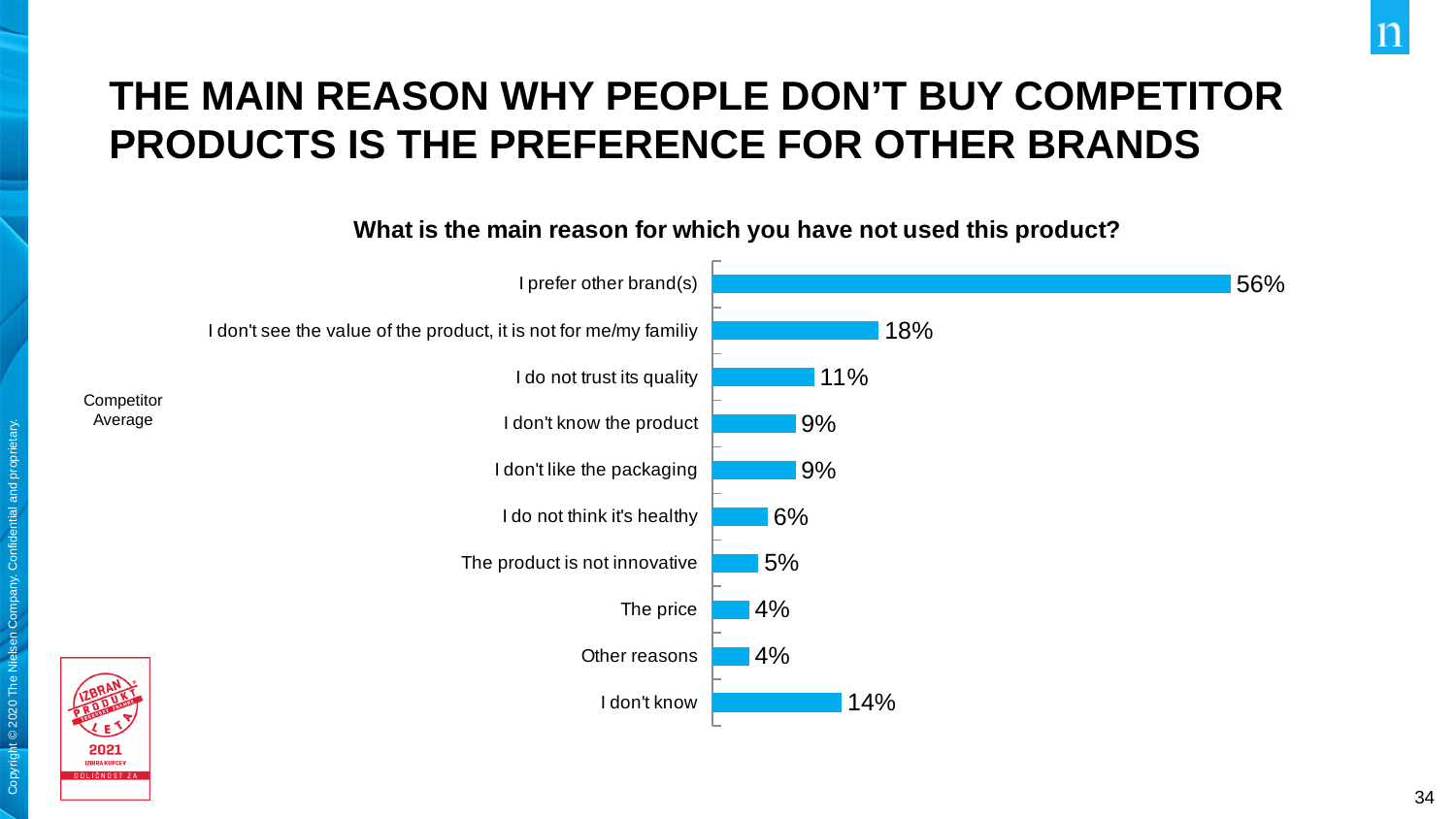
What type of chart is shown on the slide? Bar chart What is the value for "The price"? 4% What is the difference in percentage points between "I prefer other brand(s)" and "I don't see the value of the product, it is not for me/my familiy"? 38 What label appears to the left of the chart describing the data shown? Competitor Average What is the value for "I don't know"? 14% How many reason categories are shown in the chart? 10 Which is larger: the value for "I don't know" or the value for "I do not trust its quality"? I don't know What is the value for "I do not trust its quality"? 11% What question is the chart answering, as stated in its title? What is the main reason for which you have not used this product? Which reason has the highest percentage? I prefer other brand(s) What percentage of respondents said "I prefer other brand(s)" as the main reason for not using the product? 56% What is the difference in percentage points between "I do not think it's healthy" and "The product is not innovative"? 1